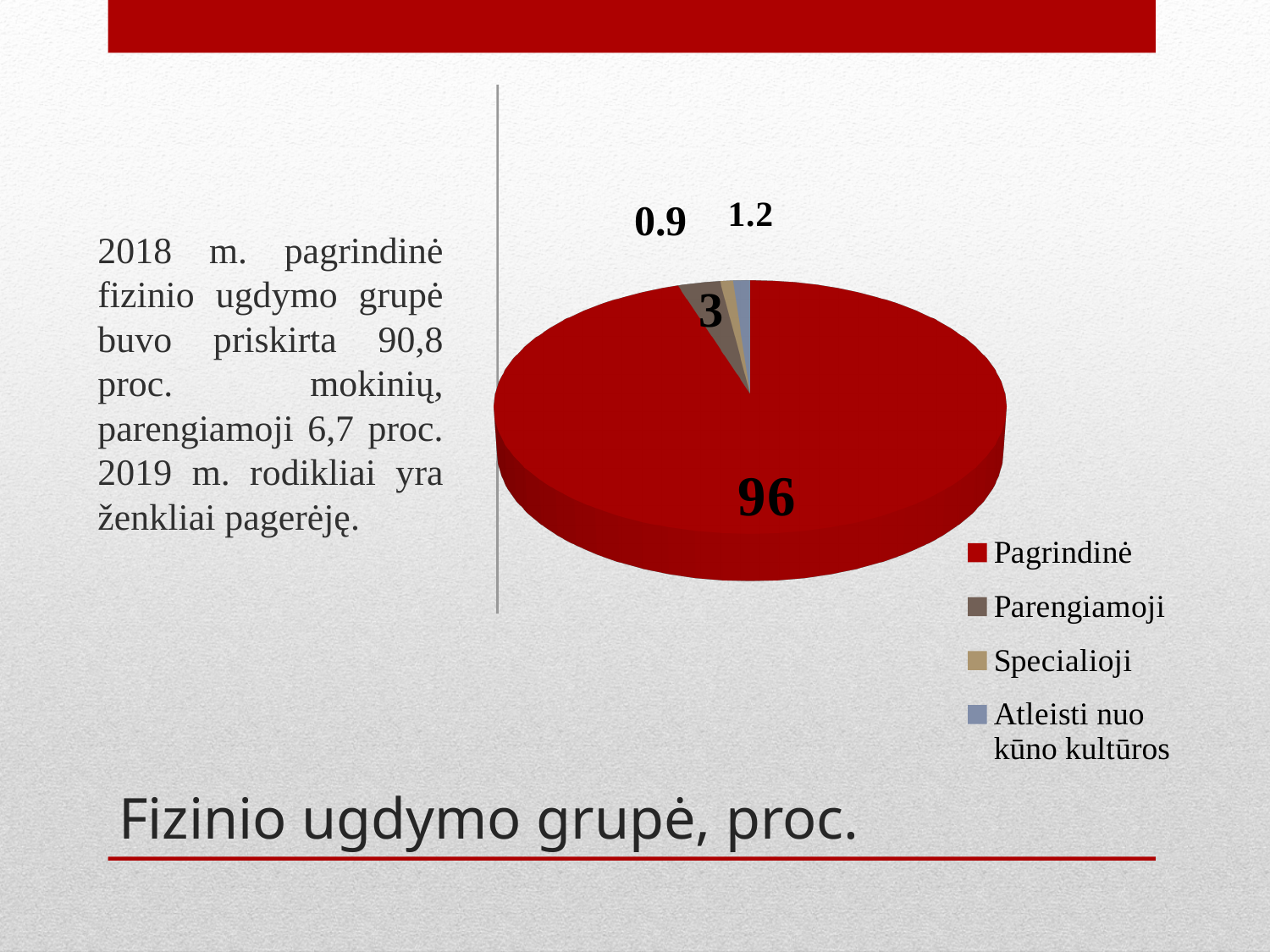
Which is larger, the value for Pagrindinė or the value for Parengiamoji? Pagrindinė What is the smallest value labelled on the pie chart? 0.9 What is the difference between the values for Pagrindinė and Parengiamoji? 93 Which category has the largest slice of the pie? Pagrindinė What colour is the slice for Pagrindinė? red How many categories does the legend list? 4 Is the value for Pagrindinė greater or less than 50? greater What is the title of the chart? Fizinio ugdymo grupė, proc. What is the value shown for Parengiamoji? 3 What is the value shown for Pagrindinė? 96 What kind of chart is shown on the slide? pie chart